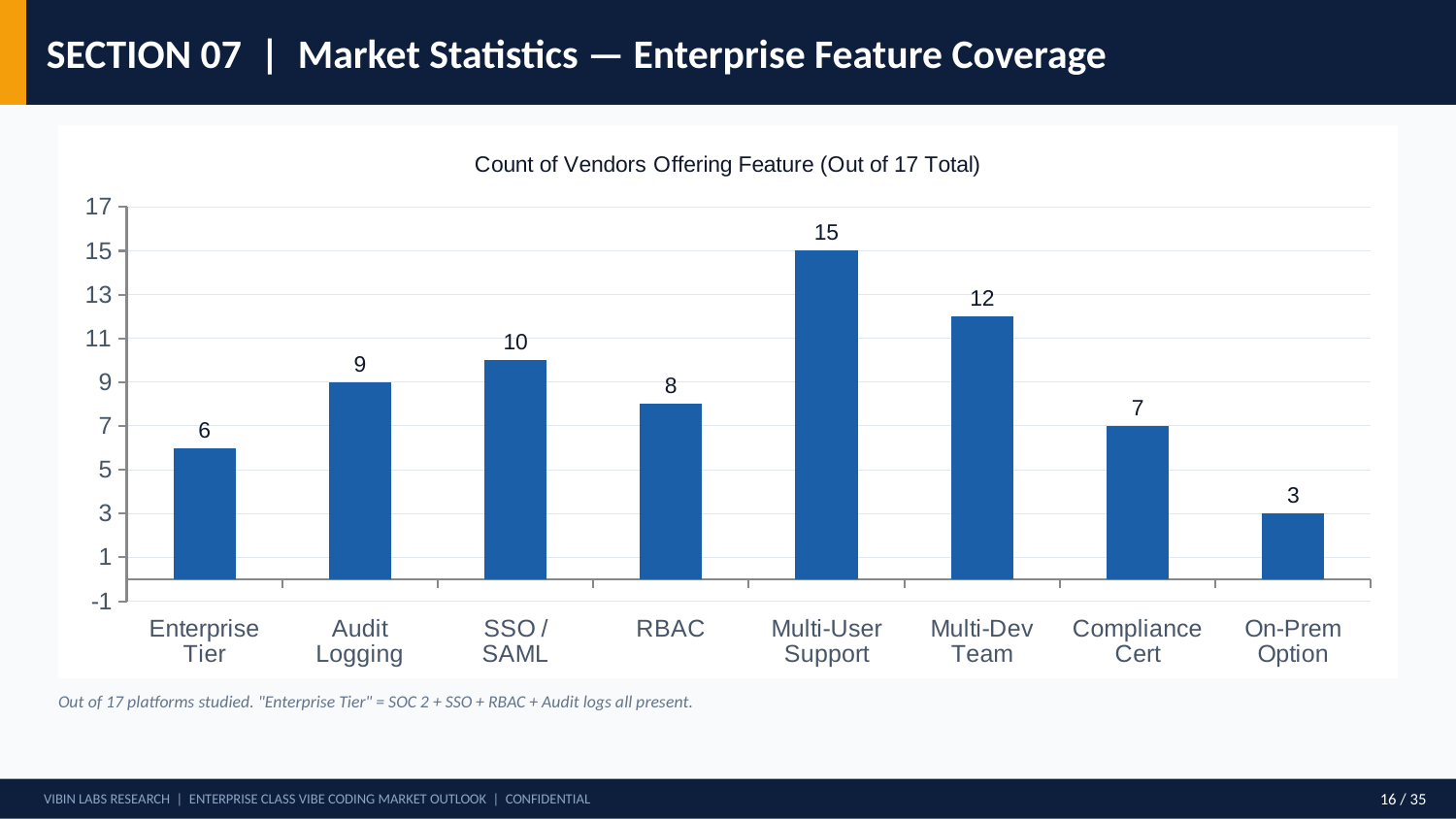
What is the difference between the values for SSO / SAML and Enterprise Tier? 4 What is the value for Compliance Cert? 7 Which feature is offered by the fewest vendors? On-Prem Option How many feature categories are shown on the x axis? 8 What is the difference between the values for Multi-User Support and Multi-Dev Team? 3 How many vendors offer an On-Prem Option? 3 What kind of chart is shown on the slide? Bar chart Which has a higher value, Audit Logging or RBAC? Audit Logging Which feature is offered by the most vendors? Multi-User Support How many vendors offer Multi-User Support? 15 What is the title of the chart? Count of Vendors Offering Feature (Out of 17 Total) Is the value for Multi-Dev Team greater or less than 11? greater